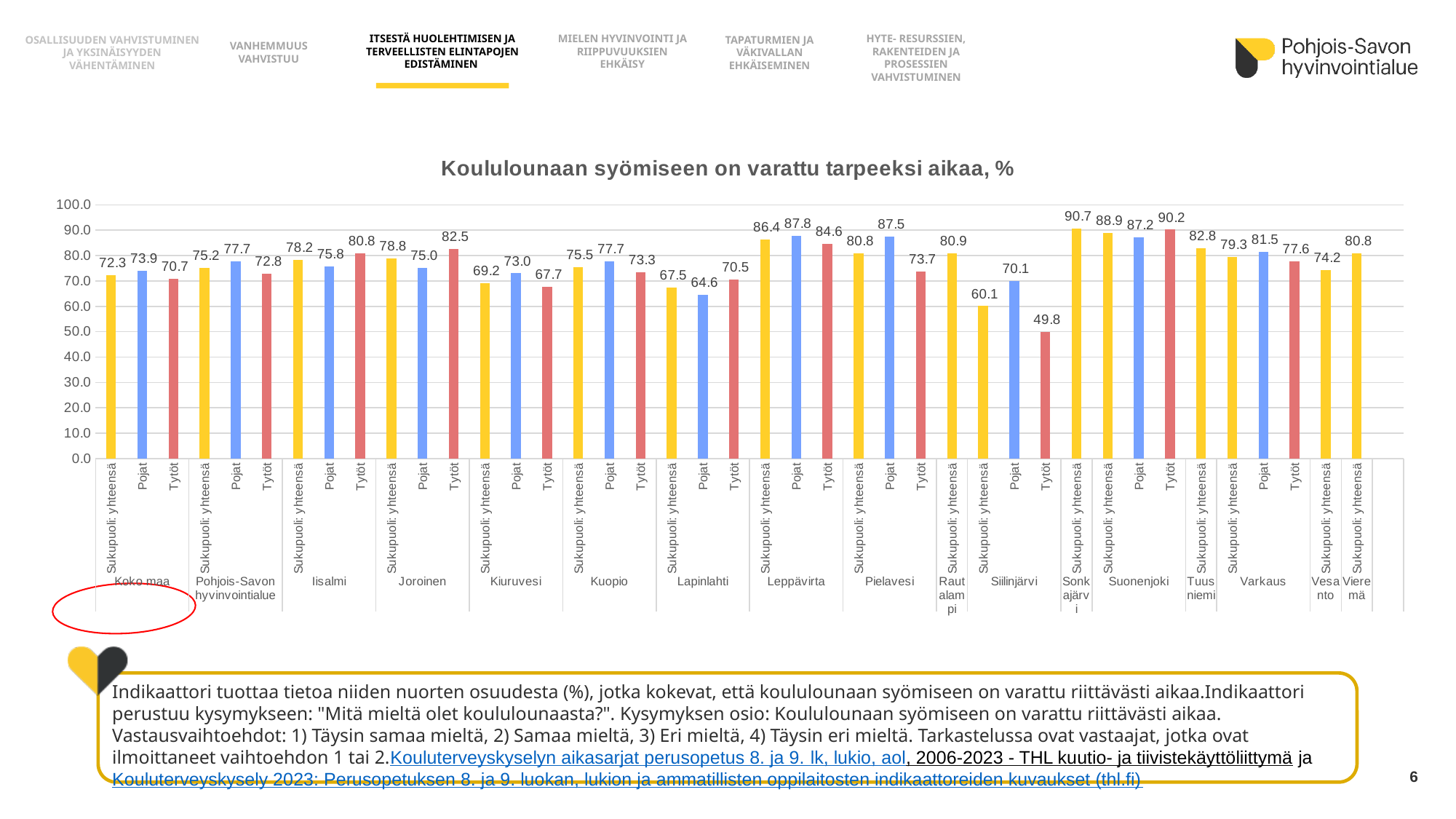
What kind of chart is shown on the slide? Bar chart Which is larger in Joroinen, the Pojat value or the Tytöt value? Tytöt What is the 'Sukupuoli: yhteensä' value for Koko maa? 72.3 How many bars are shown for Kuopio? 3 What is the title of the chart? Koululounaan syömiseen on varattu tarpeeksi aikaa, % What is the value for Sonkajärvi? 90.7 Which bar has the highest value in the chart? Sonkajärvi (90.7) Is the Tytöt value for Siilinjärvi greater or less than 50.0? less Which bar has the lowest value in the chart? Tytöt, Siilinjärvi (49.8) What is the value for Pojat in Leppävirta? 87.8 What is the difference between the Pojat and Tytöt values in Pielavesi? 13.8 What is the value for Tytöt in Siilinjärvi? 49.8